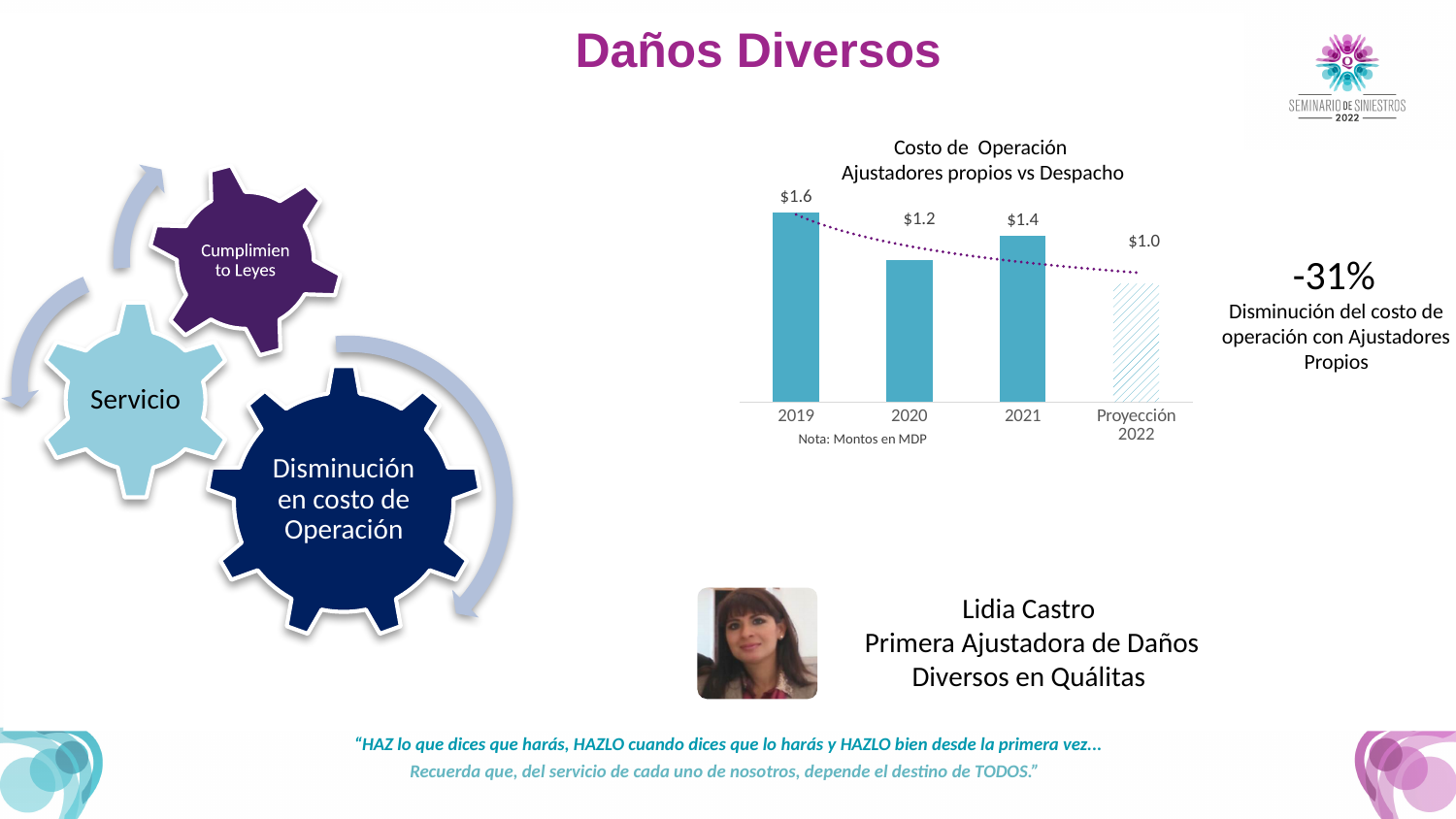
How many categories are shown on the x axis of the chart? 4 What is the value for 2021 in the chart? $1.4 What is the difference between the 2019 value and the Proyección 2022 value? $0.6 What is the value shown for Proyección 2022? $1.0 Which is larger, the value for 2020 or the value for 2021? 2021 What is the value for 2019 in the chart? $1.6 What is the value for 2020 in the chart? $1.2 What is the difference between the 2019 value and the 2021 value? $0.2 What kind of chart is shown on the slide? Bar chart Which category has the lowest value in the chart? Proyección 2022 What is the title of the chart? Costo de Operación Ajustadores propios vs Despacho Which year has the highest value in the chart? 2019